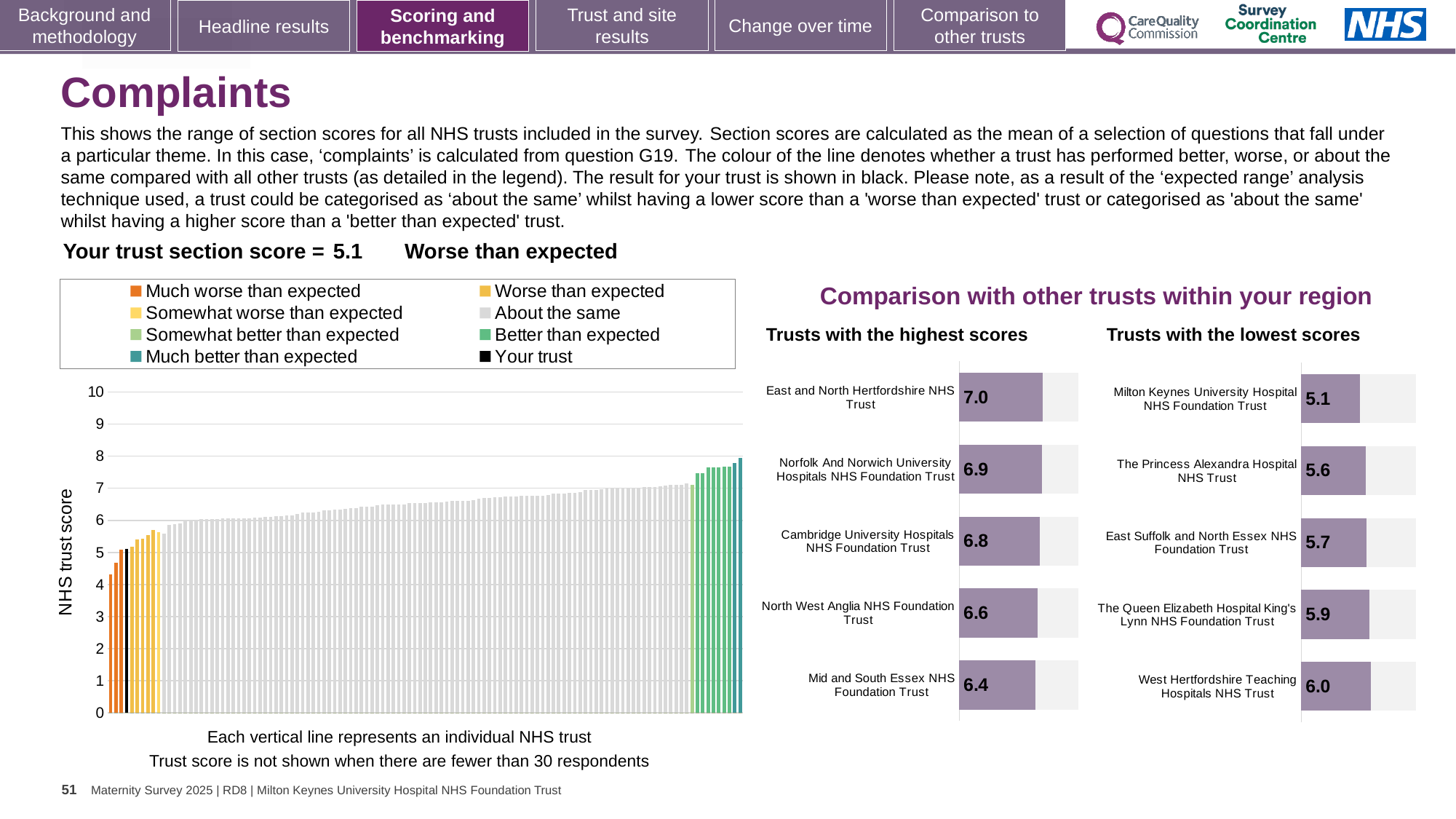
How many trusts are shown in the 'Trusts with the lowest scores' chart? 5 In the 'Trusts with the highest scores' chart, what is the difference between the scores of East and North Hertfordshire NHS Trust and Mid and South Essex NHS Foundation Trust? 0.6 In the 'Trusts with the highest scores' chart, what is the score for East and North Hertfordshire NHS Trust? 7.0 In the NHS trust score chart, is the value of the black 'Your trust' bar greater or less than 6? less In the 'Trusts with the lowest scores' chart, what is the score for The Princess Alexandra Hospital NHS Trust? 5.6 In the 'Trusts with the lowest scores' chart, which trust has the highest score? West Hertfordshire Teaching Hospitals NHS Trust In the 'Trusts with the highest scores' chart, which trust has the lowest score? Mid and South Essex NHS Foundation Trust In the NHS trust score chart, what colour represents 'Your trust' in the legend? Black How many entries does the legend of the NHS trust score chart list? 8 In the 'Trusts with the lowest scores' chart, which has the larger score: Milton Keynes University Hospital NHS Foundation Trust or The Queen Elizabeth Hospital King's Lynn NHS Foundation Trust? The Queen Elizabeth Hospital King's Lynn NHS Foundation Trust In the NHS trust score chart, do the bars rise or fall from left to right? Rise What kind of chart is the NHS trust score chart on the left? Bar chart